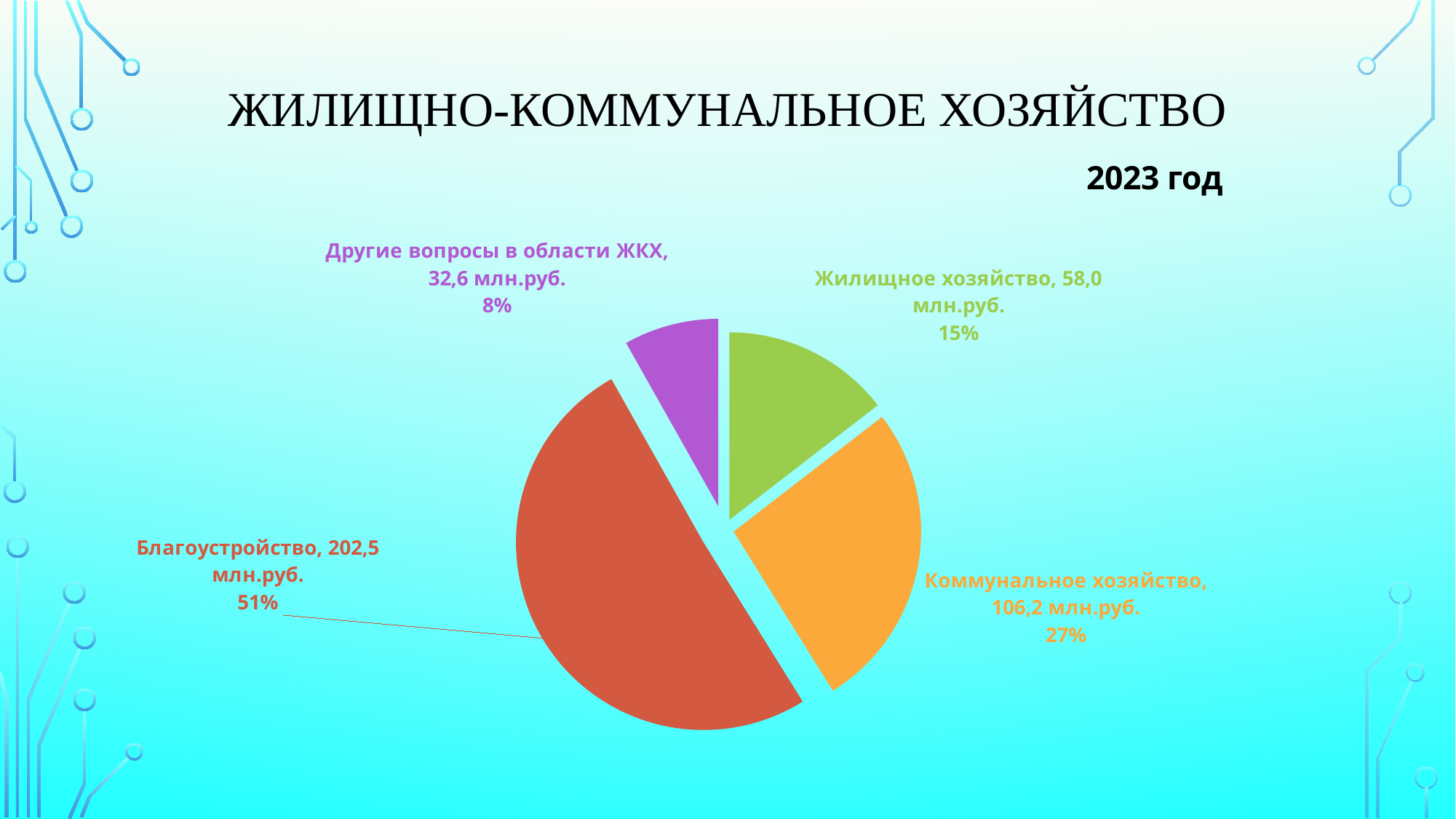
Which category has the smallest slice? Другие вопросы в области ЖКХ What is the value for Другие вопросы в области ЖКХ? 32,6 млн.руб. What share of the pie does Коммунальное хозяйство take? 27% What is the value for Жилищное хозяйство? 58,0 млн.руб. Which category has the largest slice? Благоустройство Which year does the chart refer to? 2023 год How many slices does the pie chart have? 4 What share of the pie does Другие вопросы в области ЖКХ take? 8% What kind of chart is shown on the slide? pie chart Which is larger, Жилищное хозяйство or Коммунальное хозяйство? Коммунальное хозяйство What is the value for Коммунальное хозяйство? 106,2 млн.руб. What is the value for Благоустройство? 202,5 млн.руб.